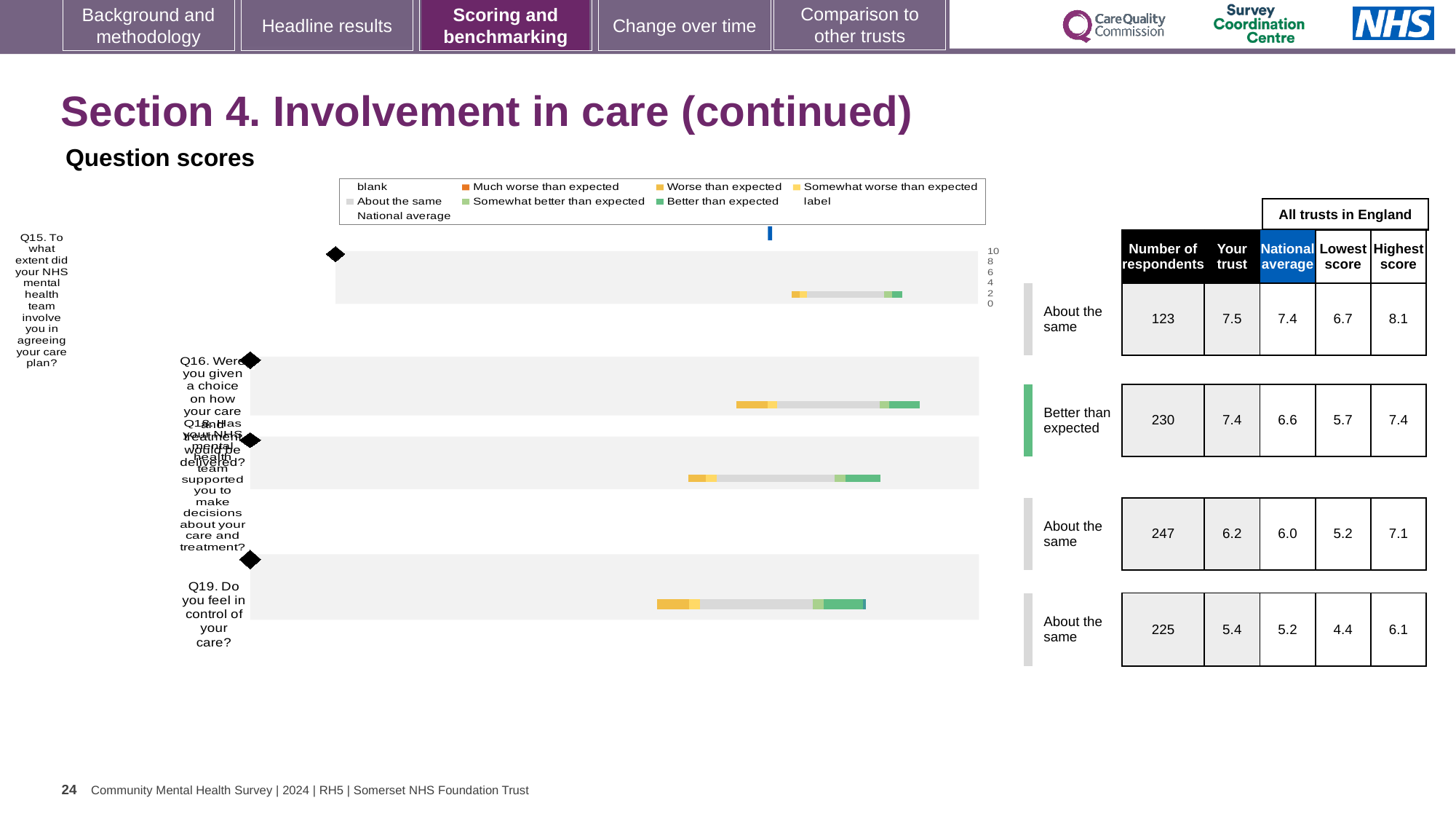
In the question scores chart legend, which entry is shown in light grey? About the same Which question has the lowest 'Your trust' score in the table beside the chart? Q19 How many entries does the legend of the question scores chart list? 9 In the table beside the chart, how many respondents answered Q18 (supported to make decisions about care and treatment)? 247 In the table beside the chart, what is the 'Your trust' score for Q15 (involving you in agreeing your care plan)? 7.5 How many questions (categories) are plotted in the question scores chart? 4 What is the difference between the 'Your trust' score and the national average for Q16 in the table beside the chart? 0.8 What kind of chart is used to show the question scores on this slide? bar chart Which question is labelled 'Better than expected' next to the chart? Q16 In the table beside the chart, what is the lowest score for Q19 (feeling in control of your care)? 4.4 In the table beside the chart, what is the national average for Q16 (choice on how care and treatment would be delivered)? 6.6 In the question scores chart legend, which entry is shown in orange? Much worse than expected